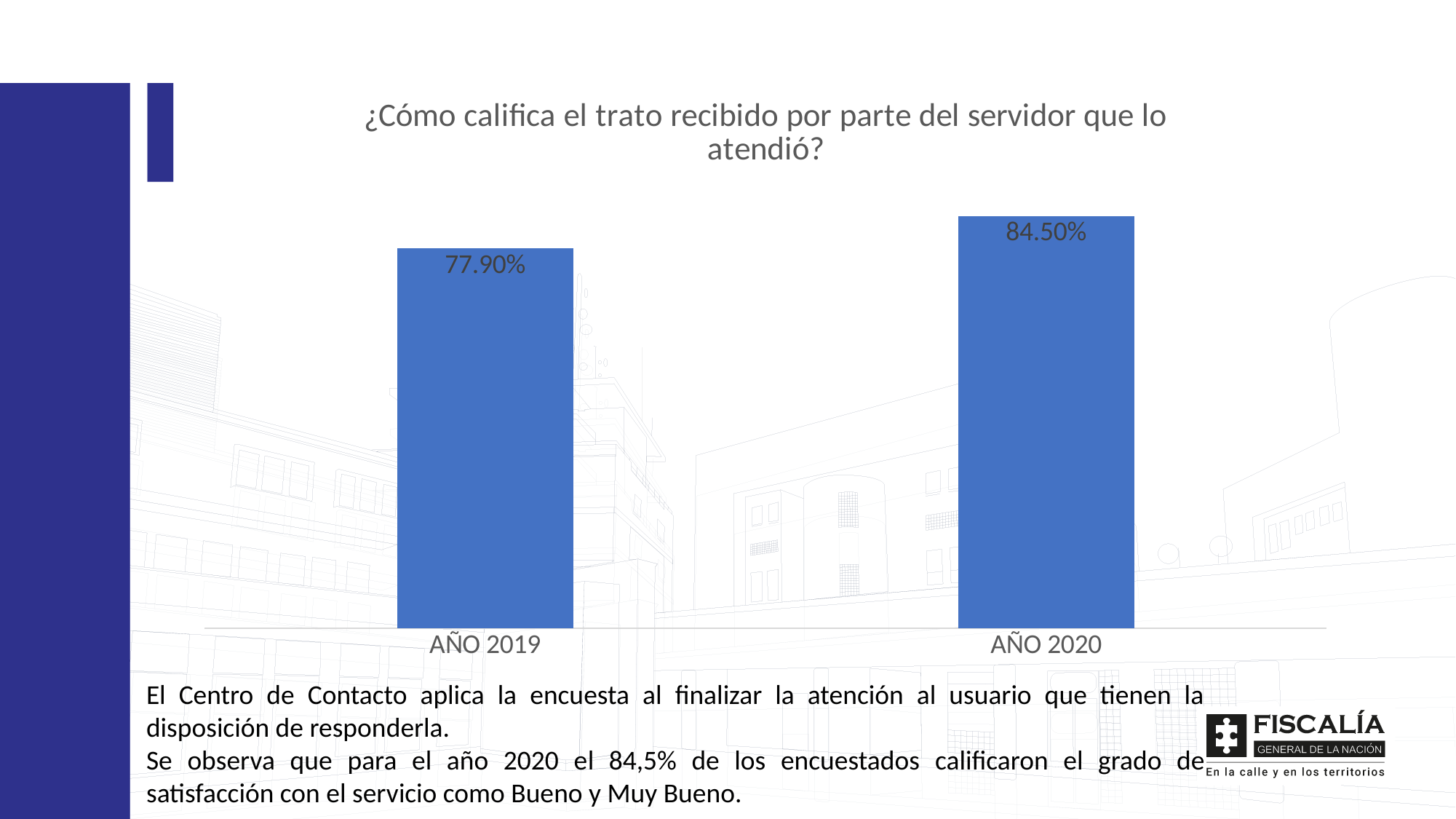
Which category has the lowest value? AÑO 2019 What kind of chart is shown on the slide? Bar chart Do the values rise or fall from AÑO 2019 to AÑO 2020? Rise Which is larger, the value for AÑO 2019 or the value for AÑO 2020? AÑO 2020 What is the difference between the values for AÑO 2020 and AÑO 2019? 6.60% What is the title of the chart? ¿Cómo califica el trato recibido por parte del servidor que lo atendió? Which category has the highest value? AÑO 2020 What colour are the bars in the chart? Blue What is the value for AÑO 2020? 84.50% What is the value for AÑO 2019? 77.90% How many categories are shown in the chart? 2